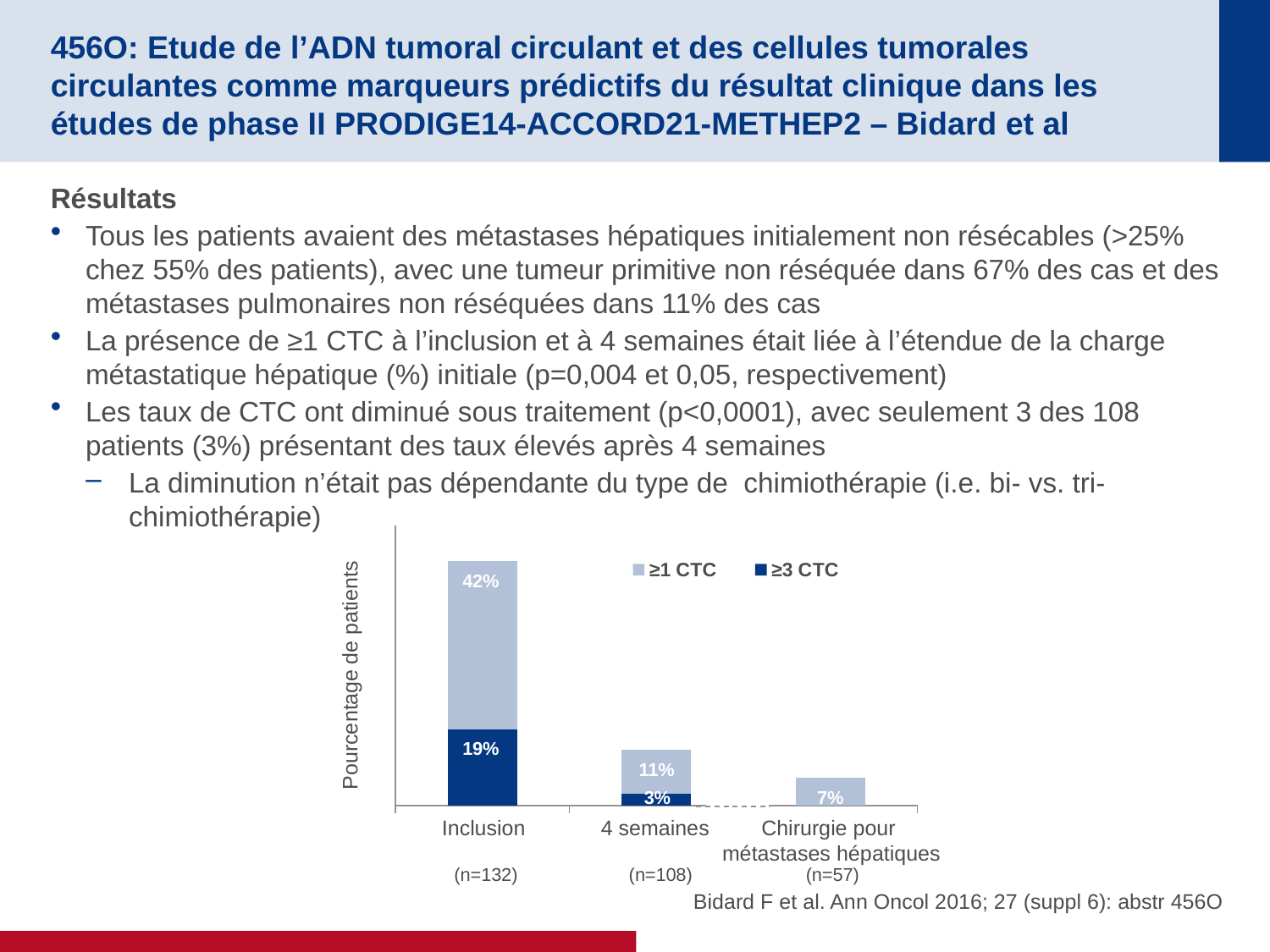
Which is larger: the ≥1 CTC value at 4 semaines or at Chirurgie pour métastases hépatiques? 4 semaines What is the difference between the ≥1 CTC values at Inclusion and at 4 semaines? 31% What is the difference between the ≥3 CTC values at Inclusion and at 4 semaines? 16% Which category has the highest value for ≥1 CTC? Inclusion What is the value for ≥1 CTC at Inclusion? 42% What is the value for ≥1 CTC at Chirurgie pour métastases hépatiques? 7% What is the value for ≥1 CTC at 4 semaines? 11% Which category has the lowest value for ≥1 CTC? Chirurgie pour métastases hépatiques What kind of chart is shown on the slide? Stacked bar chart How many series does the legend list? 2 What is the value for ≥3 CTC at 4 semaines? 3% What is the value for ≥3 CTC at Inclusion? 19%